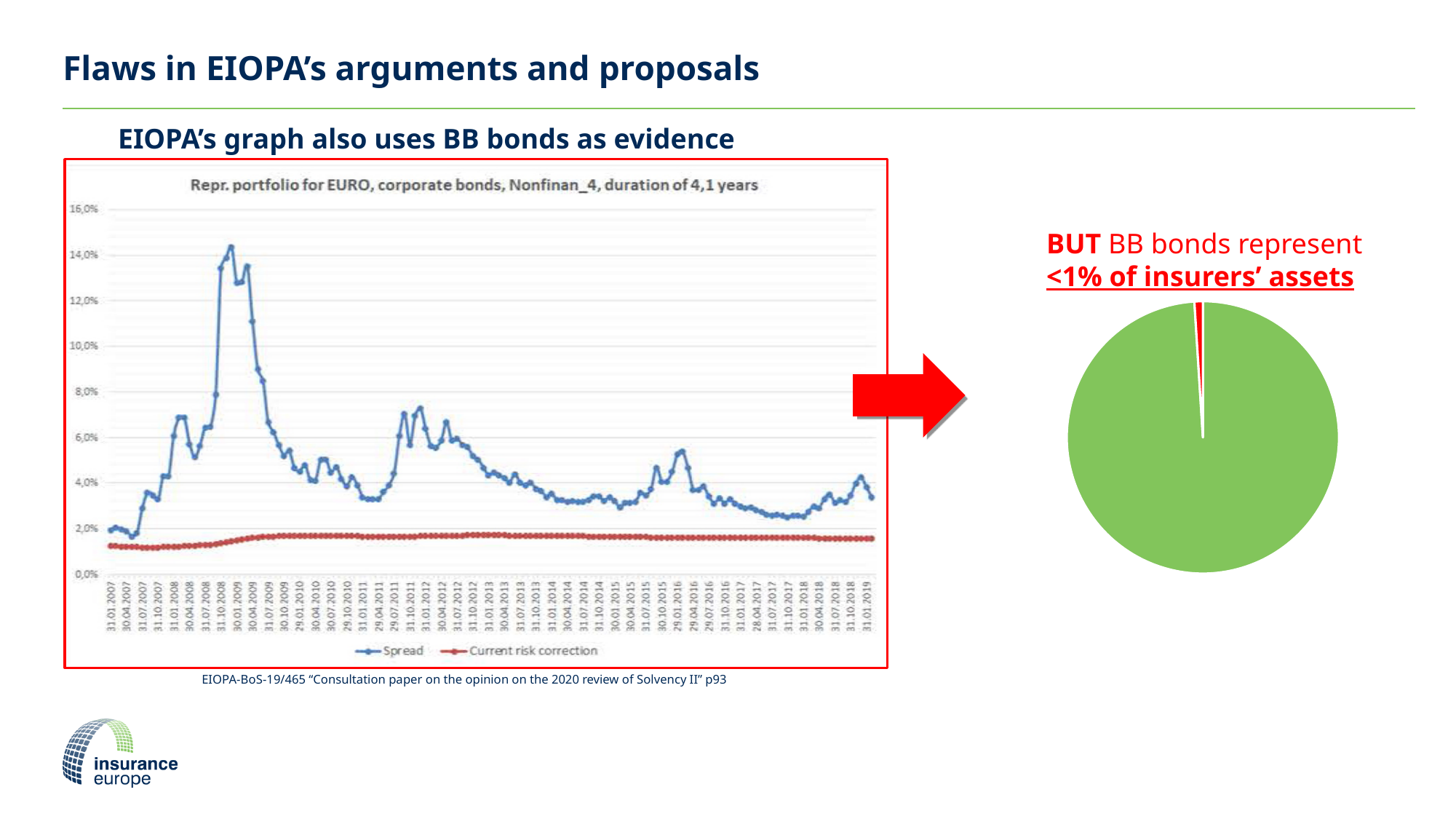
In the left chart, does the Spread series rise or fall between 31.07.2008 and 31.01.2009? rise In the left chart, is the Current risk correction series ever greater or less than 2,0% across the whole period? less What kind of chart is the chart on the right of the slide? Pie chart In the left chart, which series reaches the highest value? Spread In the left chart, how many series does the legend list? 2 In the left chart, what are the two series named in the legend? Spread and Current risk correction In the left chart, is the Spread value at 31.01.2007 greater or less than 4,0%? less In the left chart, which series is larger at 31.01.2009, Spread or Current risk correction? Spread What is the title of the left chart? Repr. portfolio for EURO, corporate bonds, Nonfinan_4, duration of 4,1 years In the pie chart on the right, which slice is larger, the green one or the red one? Green In the left chart, is the peak value of the Spread series greater or less than 12,0%? greater What kind of chart is the chart on the left of the slide? Line chart